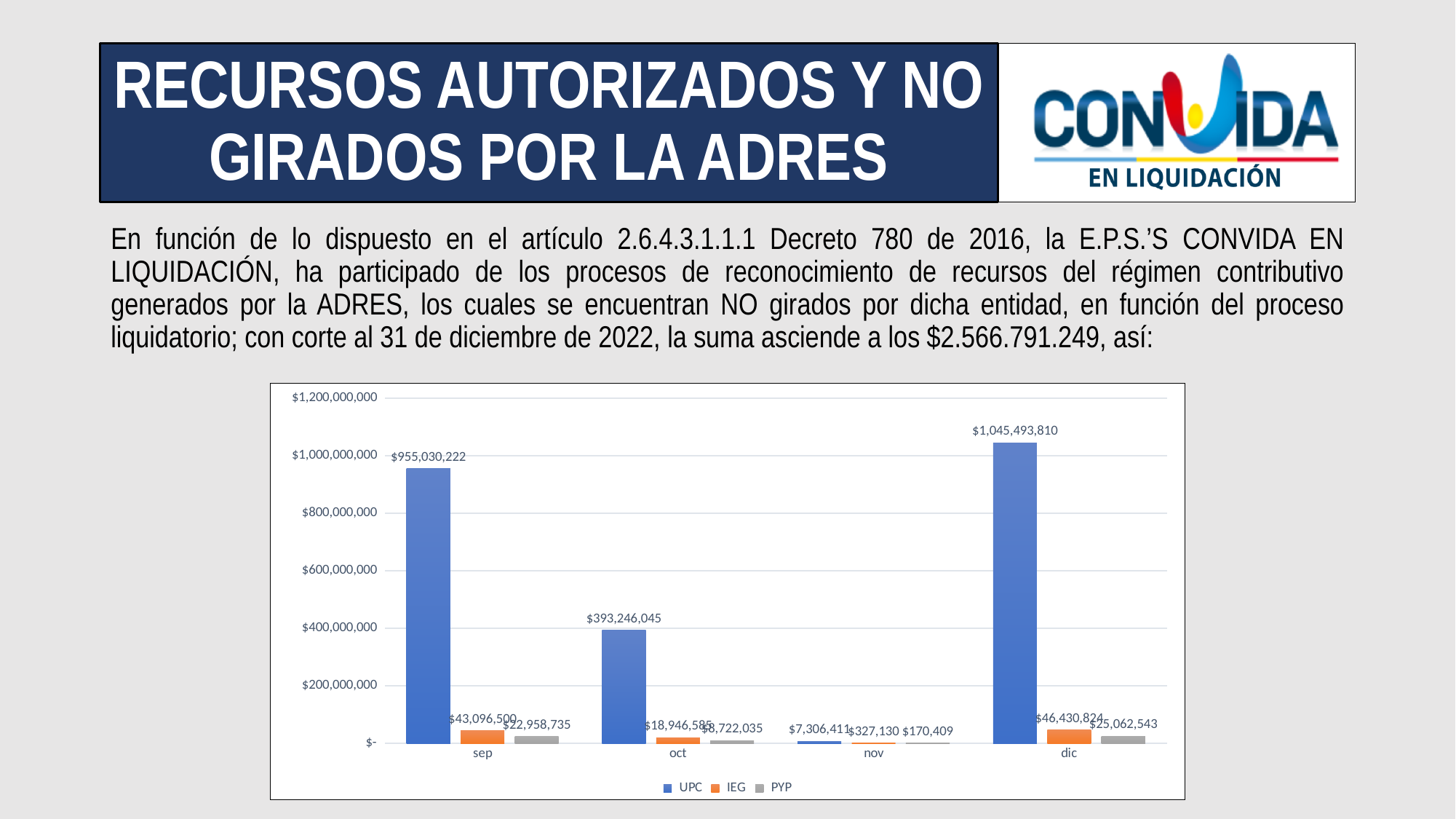
What is the IEG value for nov? $327,130 How many series does the legend list? 3 What is the UPC value for sep? $955,030,222 What is the difference between the UPC value for dic and the UPC value for sep? $90,463,588 Which month has the lowest UPC value? nov What is the UPC value for dic? $1,045,493,810 What type of chart is shown on the slide? Bar chart What is the UPC value for oct? $393,246,045 How many month categories are shown on the x axis? 4 Which month has the highest UPC value? dic What is the PYP value for dic? $25,062,543 What is the UPC value for nov? $7,306,411